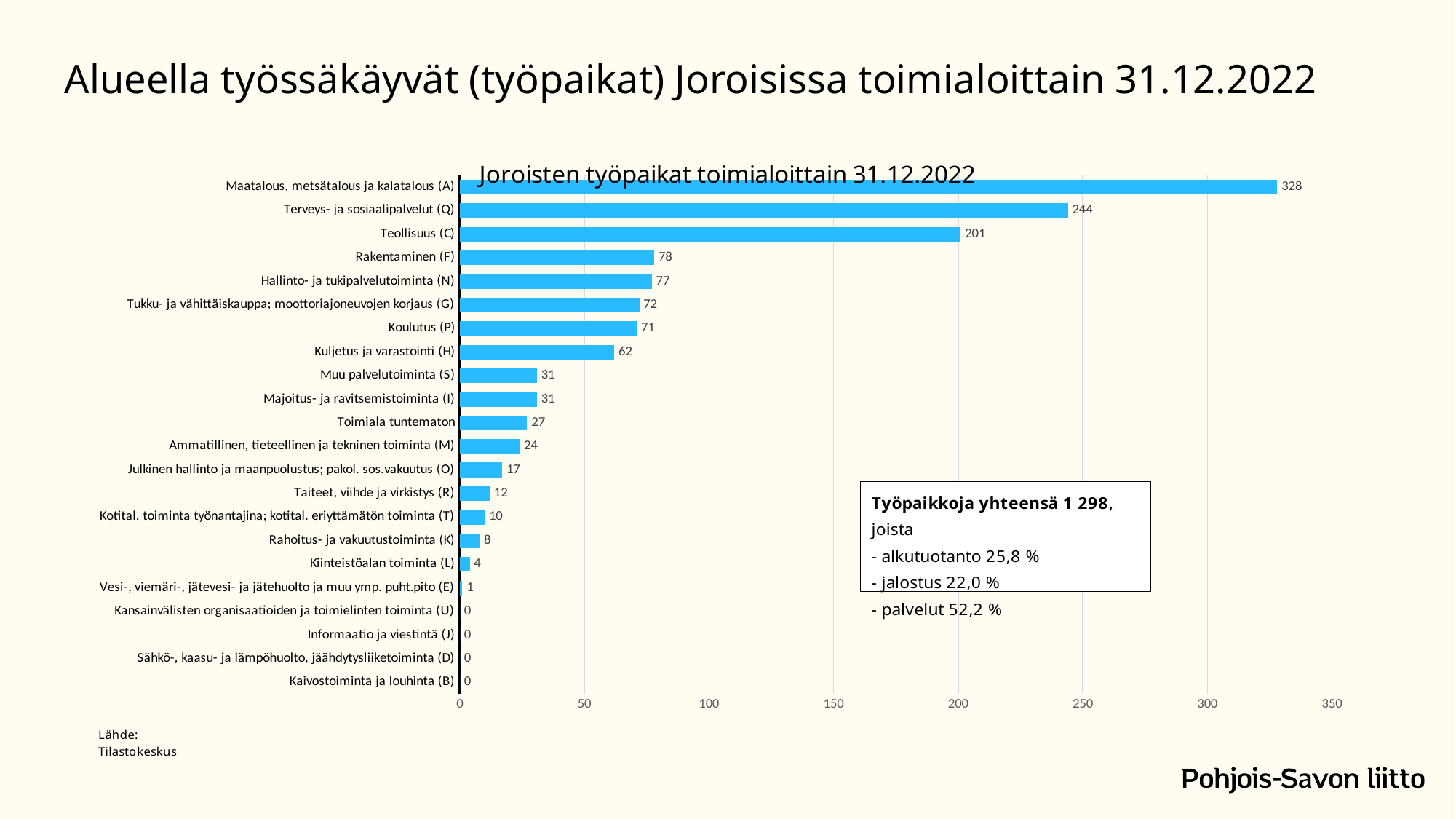
What is the title of the chart? Joroisten työpaikat toimialoittain 31.12.2022 What kind of chart is shown on the slide? Bar chart Which category has the highest value? Maatalous, metsätalous ja kalatalous (A) What is the difference between Terveys- ja sosiaalipalvelut (Q) and Teollisuus (C)? 43 What is the value for Teollisuus (C)? 201 According to the text box on the chart, what is the total number of jobs (Työpaikkoja yhteensä)? 1 298 Is the value for Terveys- ja sosiaalipalvelut (Q) greater or less than 200? greater What is the value for Kuljetus ja varastointi (H)? 62 Which is larger, Rakentaminen (F) or Koulutus (P)? Rakentaminen (F) What is the value for Rahoitus- ja vakuutustoiminta (K)? 8 How many categories are shown on the chart? 22 What is the value for Maatalous, metsätalous ja kalatalous (A)? 328